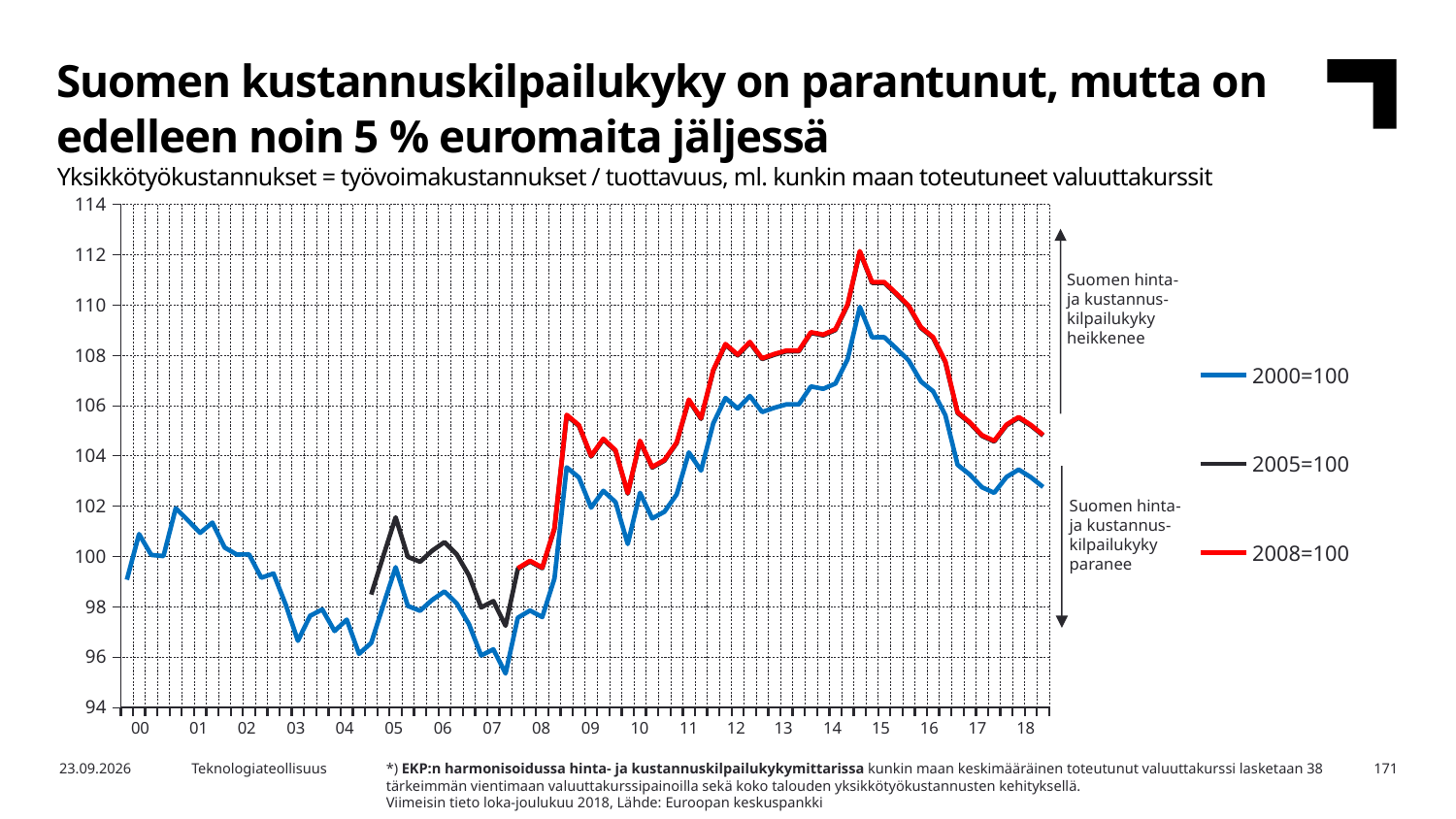
Which series is drawn in red? 2008=100 Is the value of the 2008=100 series at the end of 2018 greater or less than 106? less Does the 2000=100 series rise or fall between 2015 and 2017? fall How many year labels are shown on the x axis? 19 How many series does the legend list? 3 In 2015, which series has the higher value, 2008=100 or 2000=100? 2008=100 Which series is drawn in blue? 2000=100 Is the lowest value of the 2000=100 series, around 2007, greater or less than 98? less Is the peak value of the 2008=100 series greater or less than 110? greater What kind of chart is shown on the slide? line chart Which series reaches the highest value on the chart? 2008=100